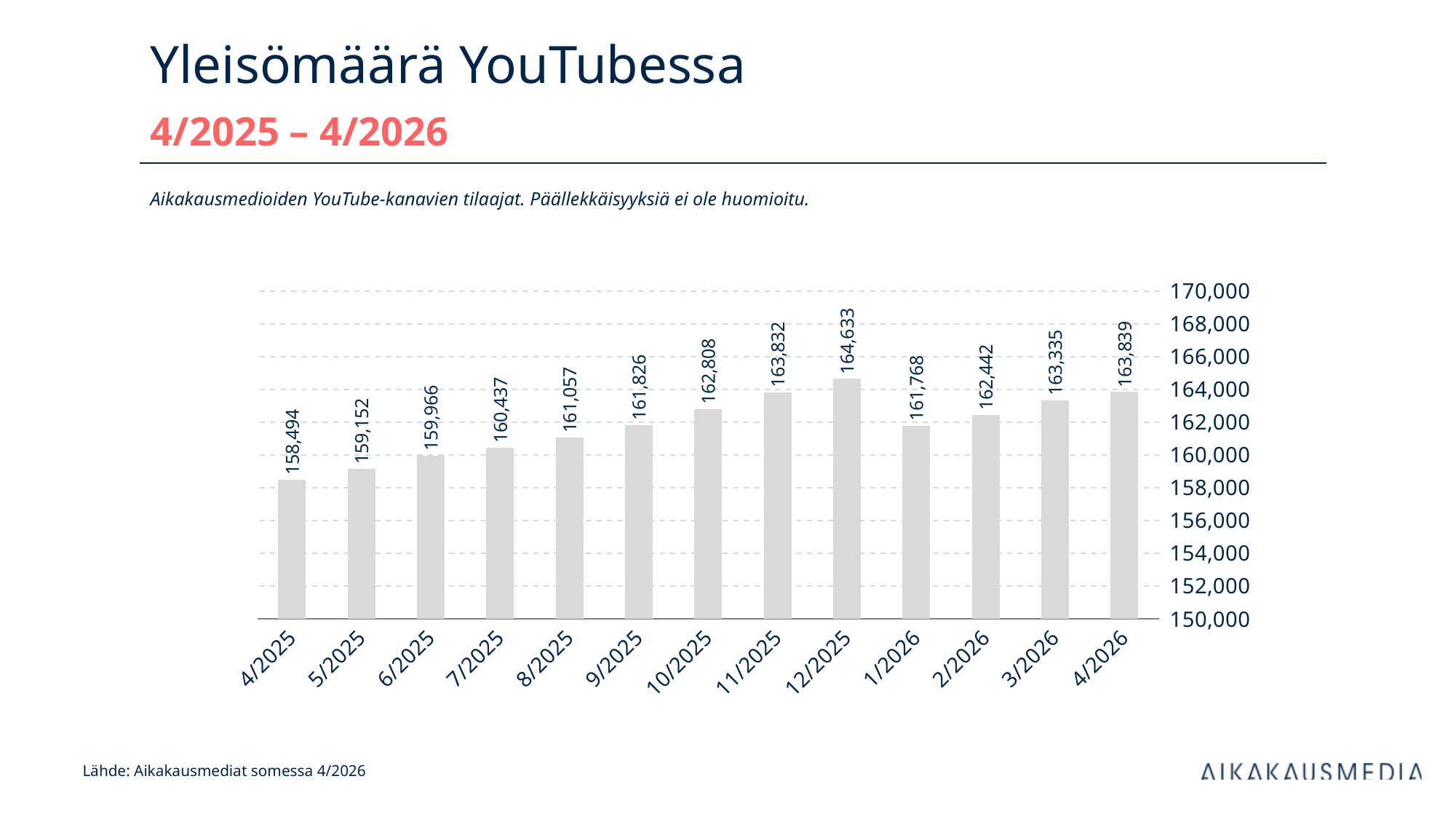
How many months are shown on the x axis? 13 What is the value for 4/2025? 158,494 Do the values rise or fall from 4/2025 to 12/2025? Rise What is the difference between the values for 12/2025 and 1/2026? 2,865 Which is larger, the value for 11/2025 or the value for 3/2026? 11/2025 What is the value for 4/2026? 163,839 What is the value for 1/2026? 161,768 Which month has the lowest value? 4/2025 What is the difference between the values for 12/2025 and 4/2025? 6,139 Which month has the highest value? 12/2025 What kind of chart is shown on the slide? Bar chart What is the value for 12/2025? 164,633